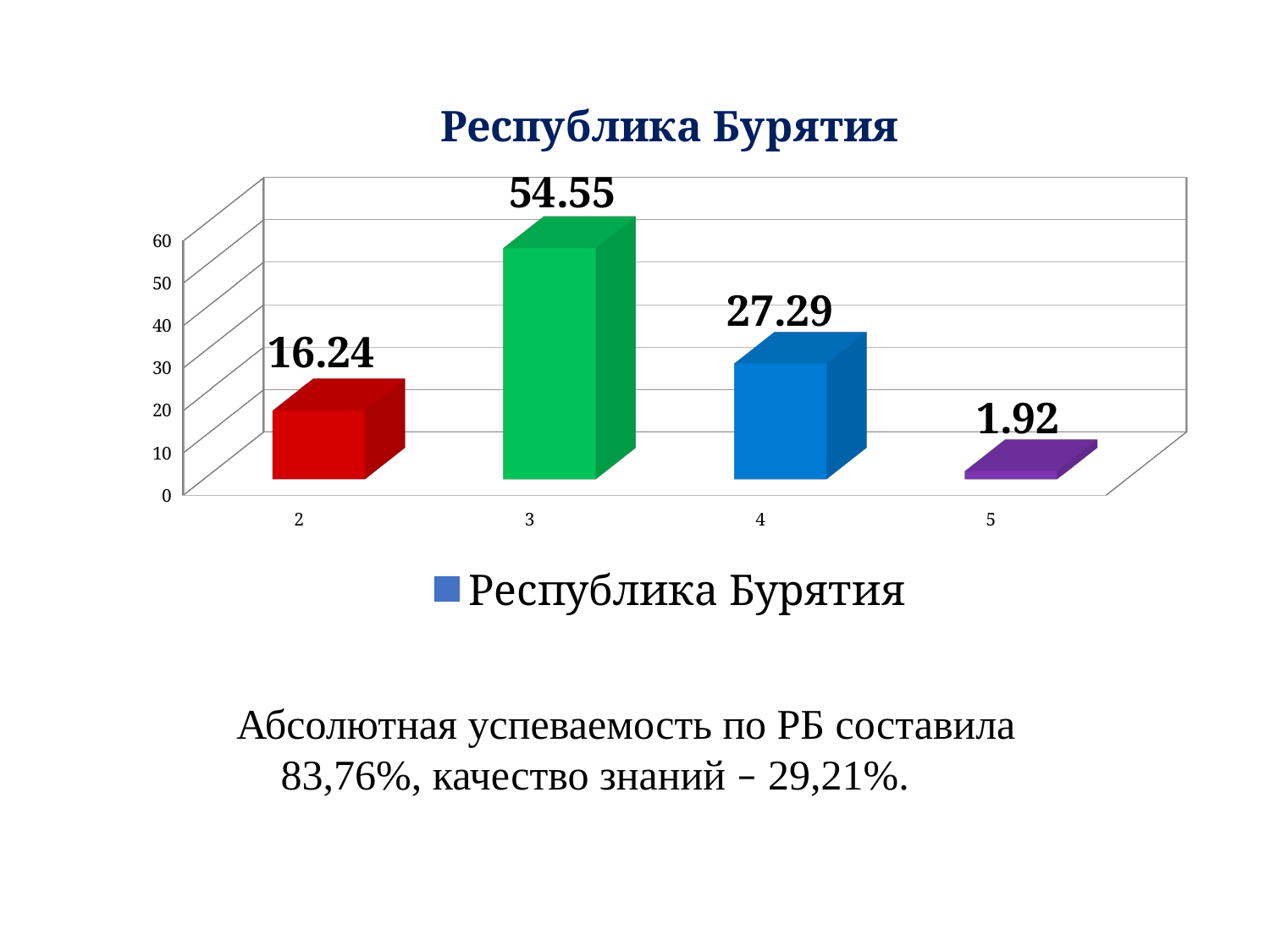
What is the title of the chart? Республика Бурятия Is the value for category 4 greater or less than 20? greater What is the difference between the values for category 3 and category 4? 27.26 Which category has the lowest value? 5 What is the value for category 5? 1.92 Which category has the highest value? 3 How many series does the legend list? 1 What is the value for category 2? 16.24 What is the value for category 3? 54.55 How many categories are shown on the x axis? 4 What kind of chart is shown on the slide? bar chart Which is larger, the value for category 2 or the value for category 4? 4